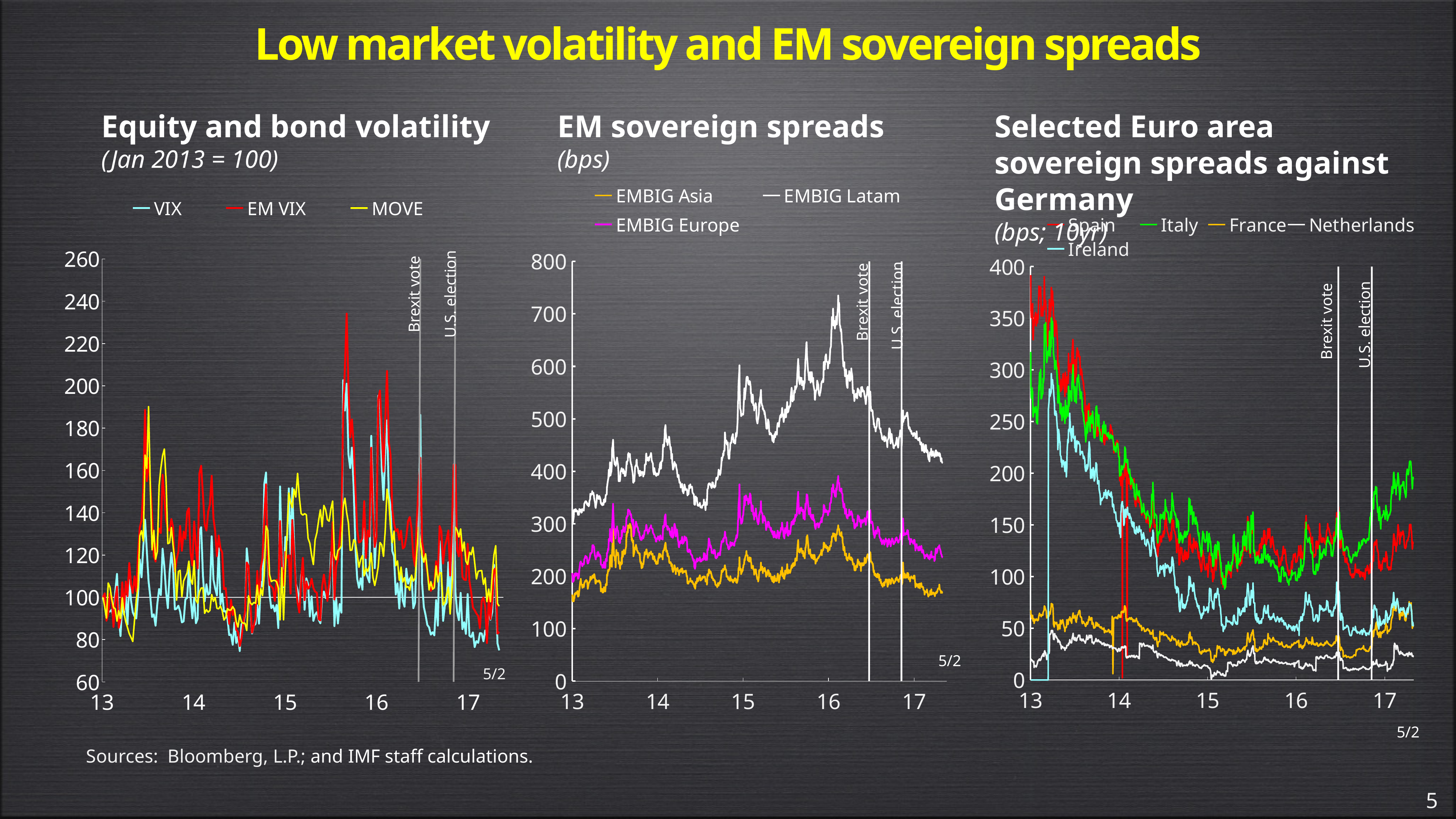
In the 'Selected Euro area sovereign spreads against Germany' chart, which is larger at the end of the series: the Italy spread or the Netherlands spread? Italy In the 'EM sovereign spreads' chart, which series has the lowest values throughout the period? EMBIG Asia How many series does the legend of the 'EM sovereign spreads' chart list? 3 In the 'EM sovereign spreads' chart, is the peak value of EMBIG Latam in 2016 greater or less than 600? greater In the 'Selected Euro area sovereign spreads against Germany' chart, is the Spain spread at the start of 2013 greater or less than 300? greater In the 'EM sovereign spreads' chart, is the value of EMBIG Asia at the start of 2013 greater or less than 200? less What two events are marked by vertical lines on the charts? Brexit vote and U.S. election In the 'Selected Euro area sovereign spreads against Germany' chart, does the Italy spread generally rise or fall between 2013 and 2015? fall How many series does the legend of the 'Selected Euro area sovereign spreads against Germany' chart list? 5 In the 'EM sovereign spreads' chart, which series has the highest values throughout the period? EMBIG Latam What kind of chart is the 'Equity and bond volatility' chart? line chart